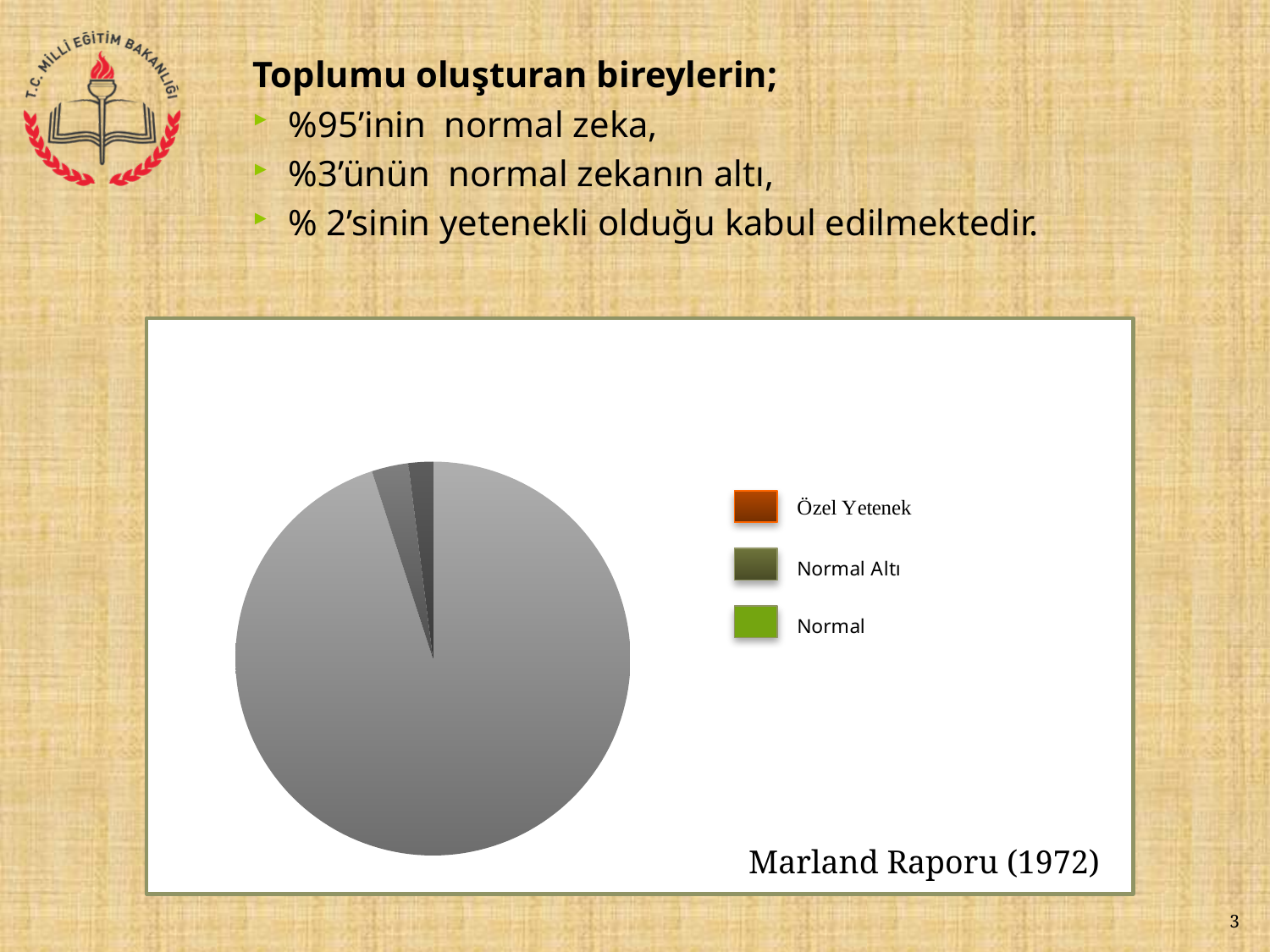
According to the slide, what share of the pie does the Normal Altı slice represent? %3 According to the slide, what share of the pie does the Özel Yetenek slice represent? %2 What source is cited in the bottom right corner of the chart area? Marland Raporu (1972) Which category has the largest slice in the pie chart? Normal According to the slide, what share of the pie does the Normal slice represent? %95 How many slices does the pie chart have? 3 How many entries does the legend of the pie chart list? 3 What are the three legend entries of the pie chart? Özel Yetenek, Normal Altı, Normal What kind of chart is shown on the slide? pie chart Which slice is larger in the pie chart, Normal or Özel Yetenek? Normal Which slice is larger in the pie chart, Normal or Normal Altı? Normal